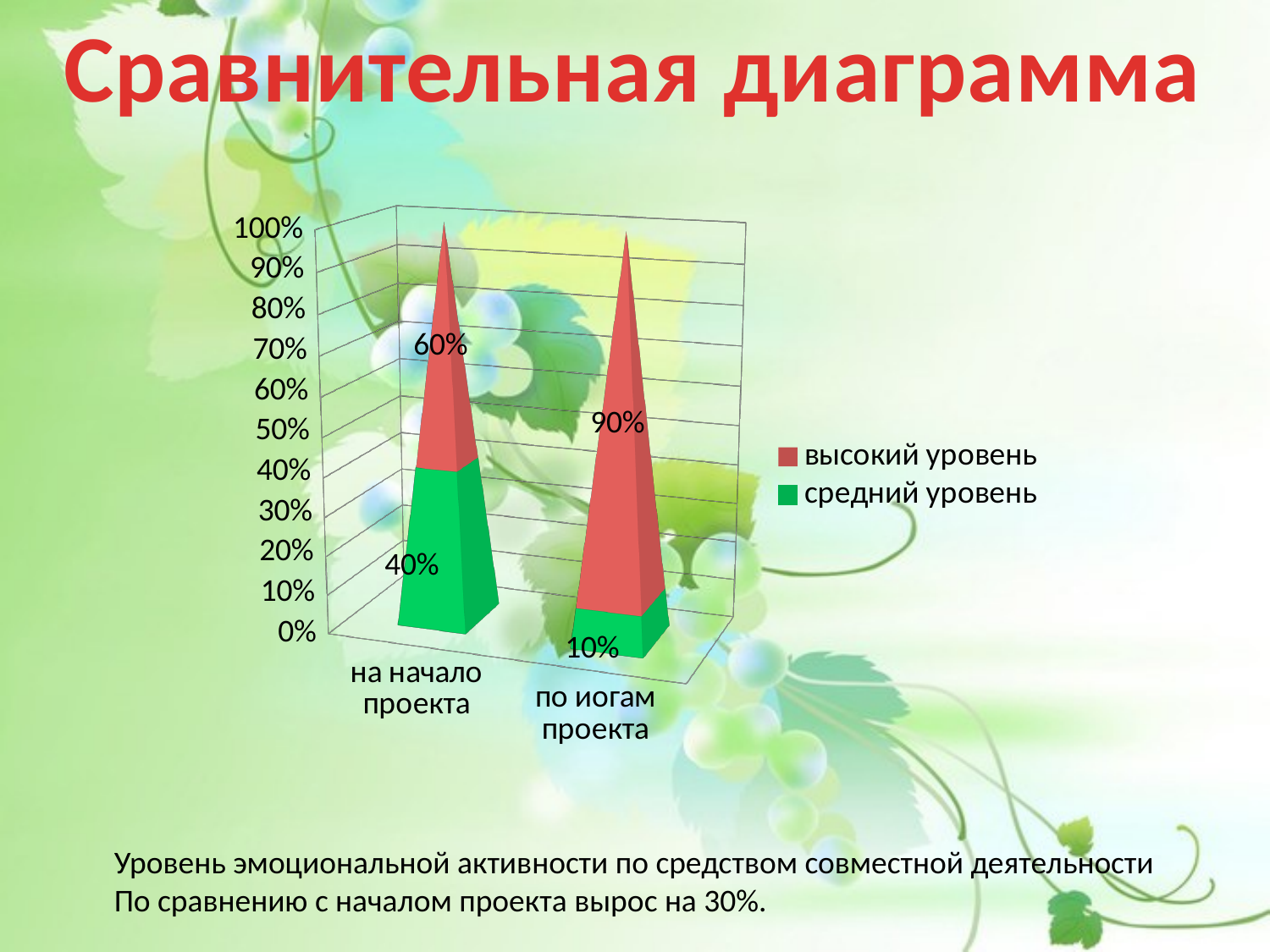
What is the value for "средний уровень" in the category "на начало проекта"? 40% What is the title of the slide containing the chart? Сравнительная диаграмма How many categories are shown on the x axis of the chart? 2 What is the difference between the "высокий уровень" values for "по иогам проекта" and "на начало проекта"? 30% How many series does the legend list? 2 In which category is the value for "высокий уровень" highest? по иогам проекта What is the value for "высокий уровень" in the category "на начало проекта"? 60% What is the value for "средний уровень" in the category "по иогам проекта"? 10% In which category is the value for "средний уровень" lowest? по иогам проекта What is the value for "высокий уровень" in the category "по иогам проекта"? 90% Which is larger: "средний уровень" for "на начало проекта" or "средний уровень" for "по иогам проекта"? на начало проекта What is the total of the stacked bar for "на начало проекта"? 100%